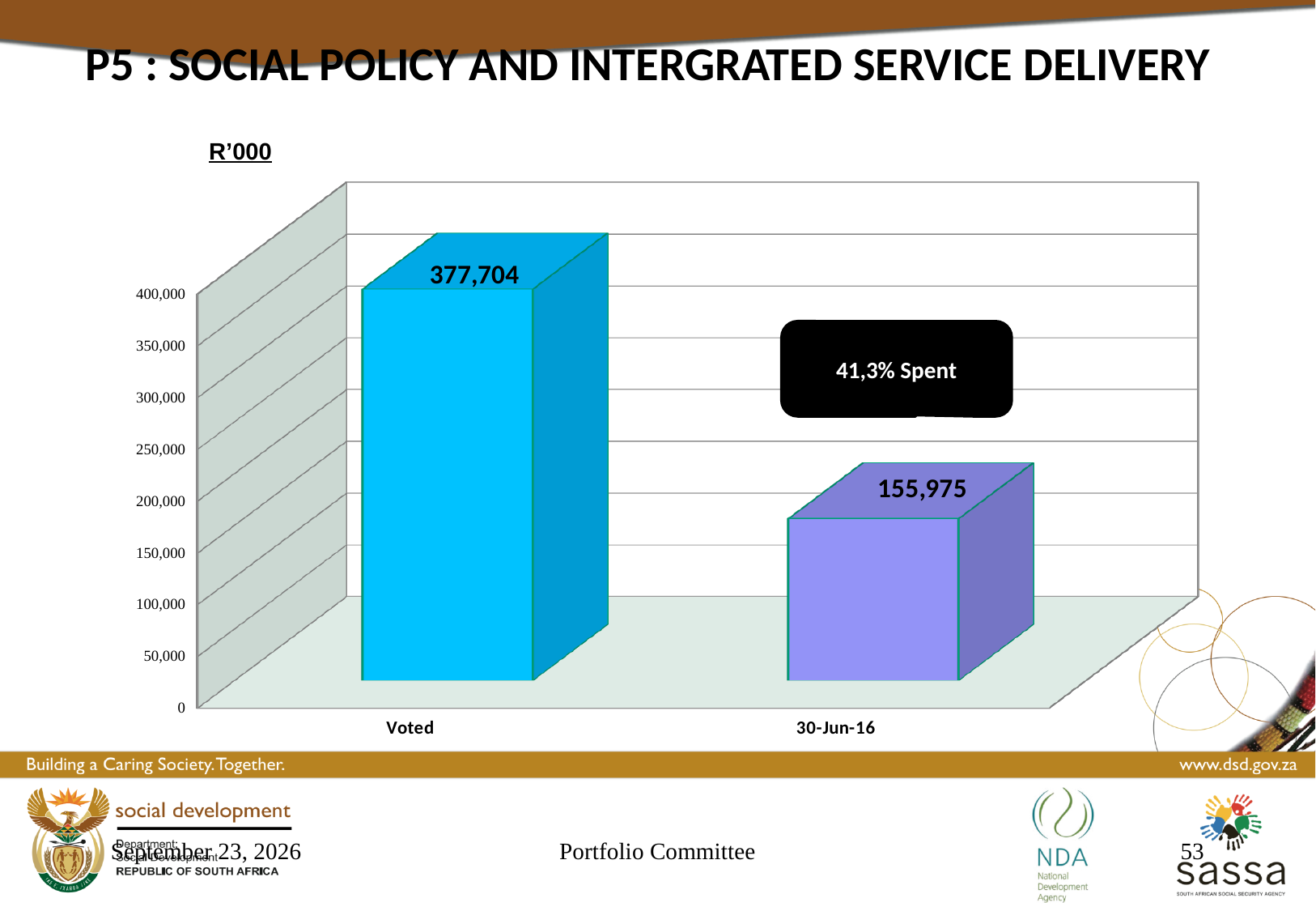
Which category has the highest value? Voted What kind of chart is shown on the slide? bar chart What percentage spent is shown in the callout on the chart? 41,3% Spent Which is larger, the value for Voted or the value for 30-Jun-16? Voted Is the value for Voted greater or less than 300,000? greater What is the difference between the Voted value and the 30-Jun-16 value? 221,729 What is the value for Voted? 377,704 What unit label is shown above the chart? R'000 How many categories are shown on the chart? 2 What is the value for 30-Jun-16? 155,975 Is the value for 30-Jun-16 greater or less than 200,000? less Which category has the lowest value? 30-Jun-16